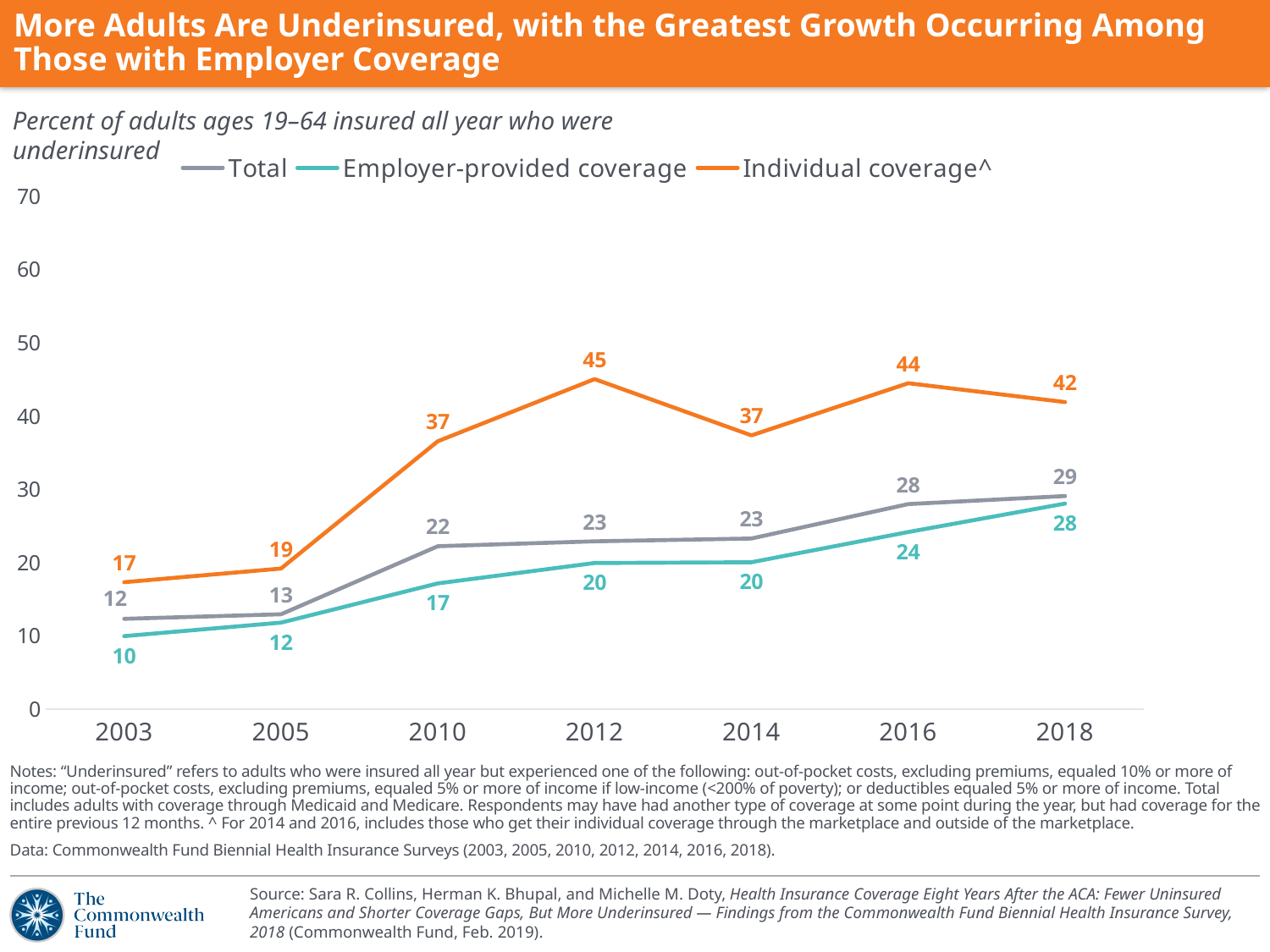
What is the value for Individual coverage in 2012? 45 What colour is the line for Individual coverage? Orange What kind of chart is shown on the slide? Line chart Which is larger in 2016: the Total value or the Employer-provided coverage value? Total How many series does the legend list? 3 In which year is the Individual coverage series highest? 2012 What is the Total value in 2018? 29 What is the difference between the Individual coverage value and the Employer-provided coverage value in 2010? 20 What is the value for Employer-provided coverage in 2003? 10 How many years are plotted on the x axis? 7 In which year is the Employer-provided coverage series lowest? 2003 Does the Employer-provided coverage series rise or fall from 2003 to 2018? Rise